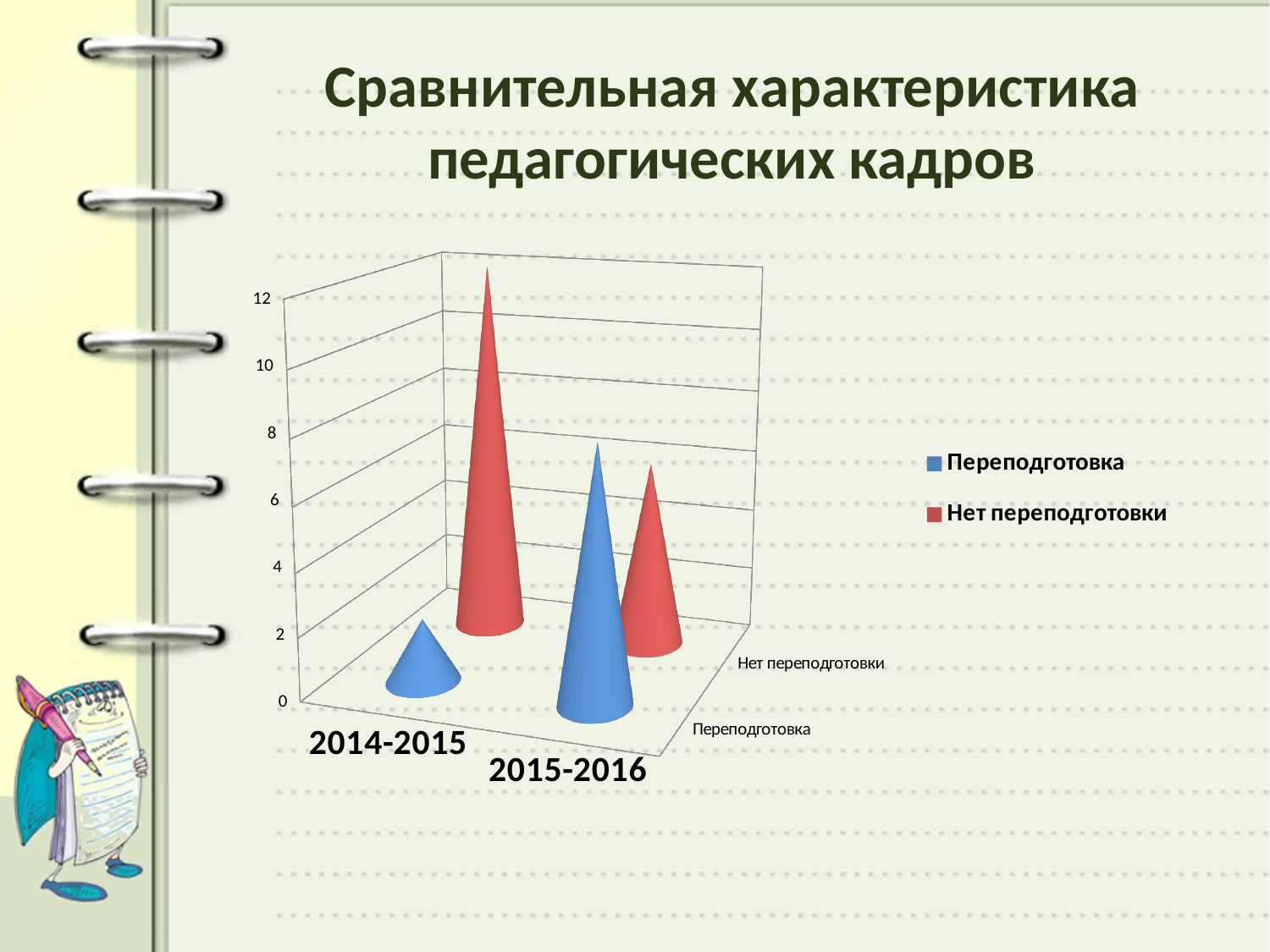
Is the value for Переподготовка in 2014-2015 greater or less than 4? less Which bar is the shortest in the chart? Переподготовка in 2014-2015 Does the value for Переподготовка rise or fall from 2014-2015 to 2015-2016? rise Which bar is the tallest in the chart? Нет переподготовки in 2014-2015 What kind of chart is shown on the slide? bar chart In 2014-2015, which series has the larger value, Переподготовка or Нет переподготовки? Нет переподготовки Which year has the higher value for Нет переподготовки, 2014-2015 or 2015-2016? 2014-2015 What are the two series named in the legend? Переподготовка, Нет переподготовки How many series does the legend list? 2 How many year categories are shown on the x axis? 2 What is the title of the slide containing the chart? Сравнительная характеристика педагогических кадров Is the value for Нет переподготовки in 2014-2015 greater or less than 8? greater